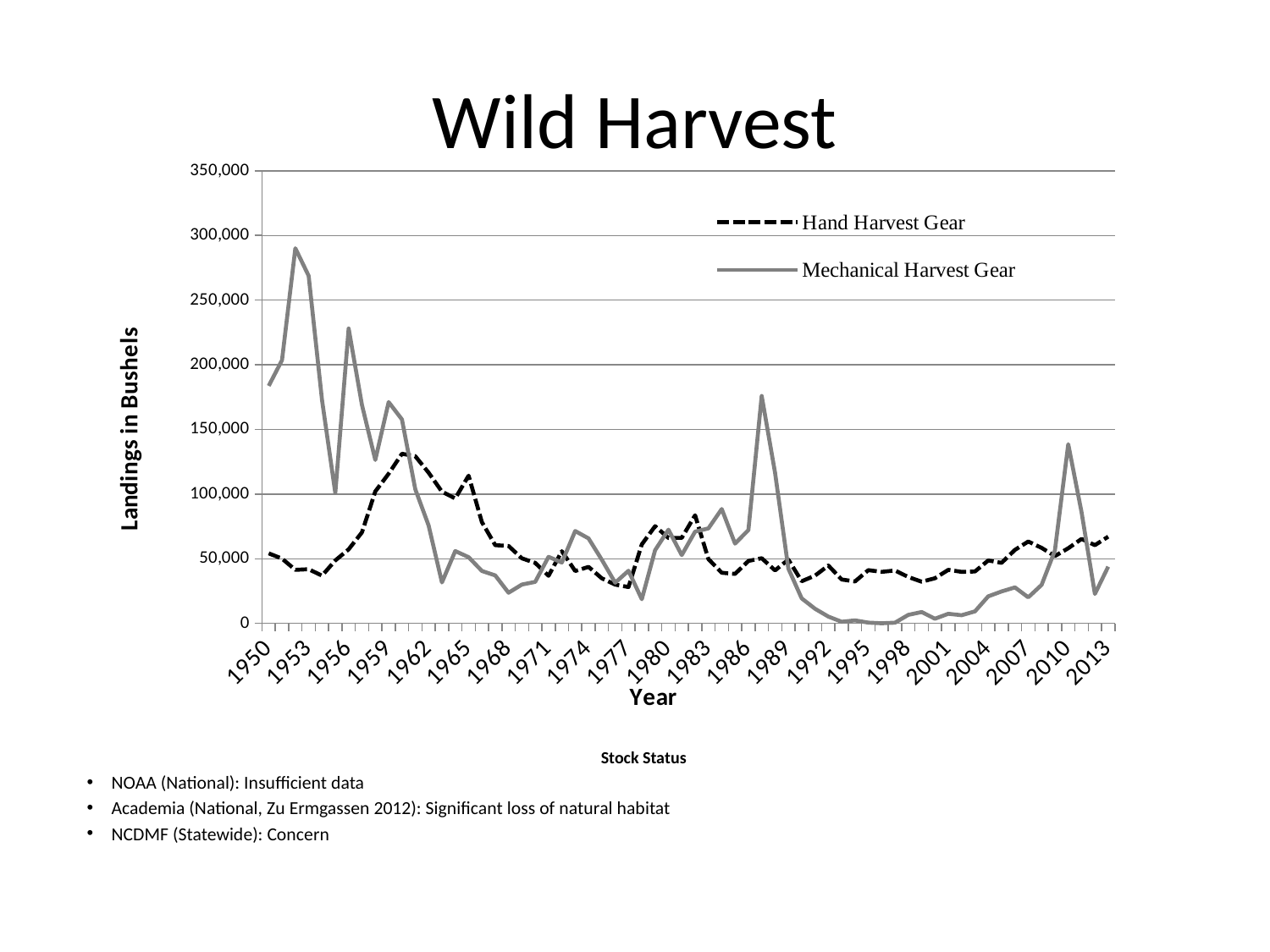
Is the value for Mechanical Harvest Gear in 1995 greater or less than 50,000? less Is the value for Mechanical Harvest Gear in 2010 greater or less than 100,000? greater What is the title of the chart? Wild Harvest What kind of chart is shown on the slide? Line chart Which series reaches the highest value anywhere on the chart? Mechanical Harvest Gear Is the value for Mechanical Harvest Gear in 1950 greater or less than 150,000? greater What is the label of the vertical axis? Landings in Bushels Overall, do the Mechanical Harvest Gear values rise or fall from 1953 to 1995? fall In 1953, which series has the larger value, Hand Harvest Gear or Mechanical Harvest Gear? Mechanical Harvest Gear How many series does the legend list? 2